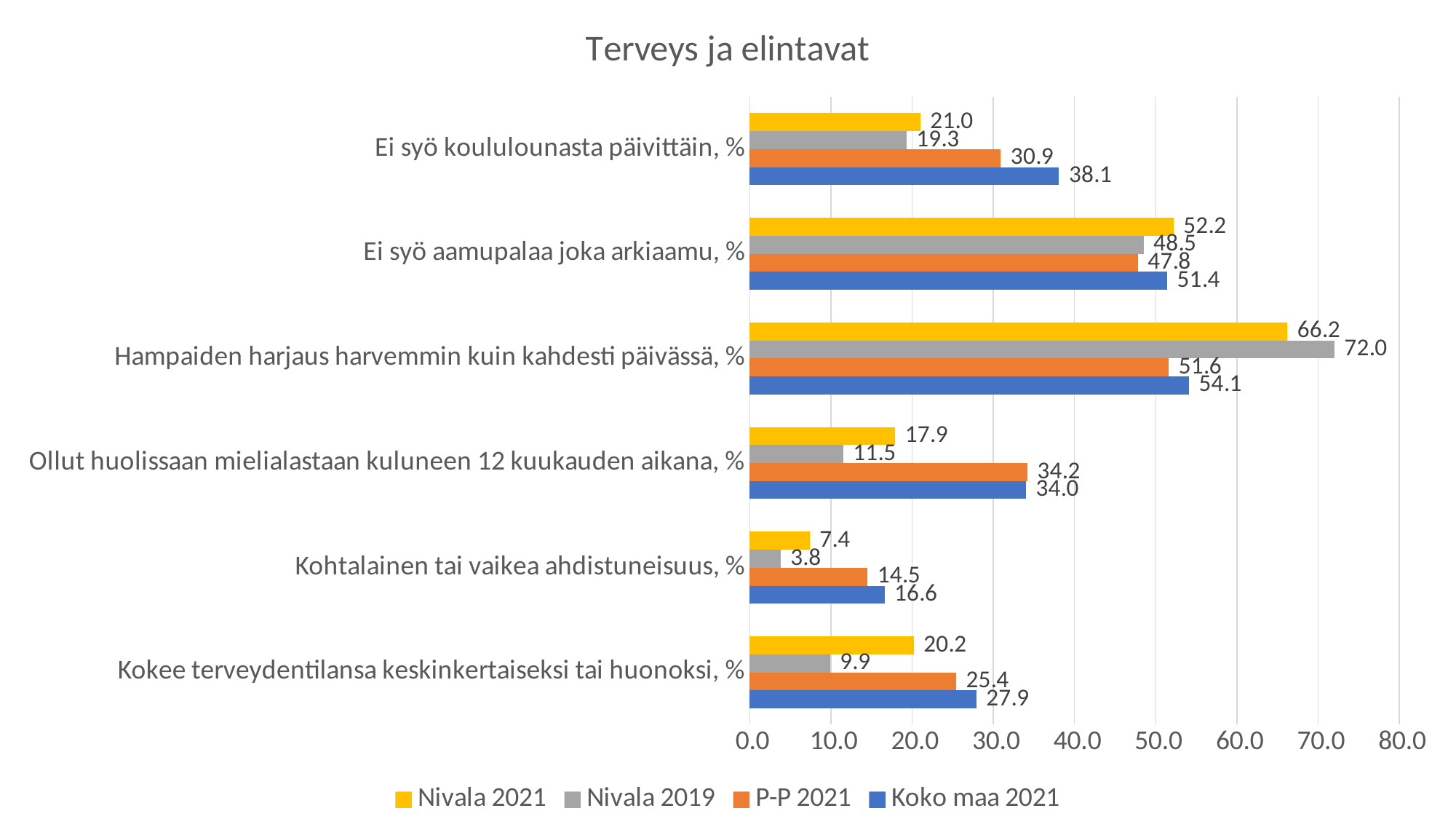
Which category has the highest value for the Nivala 2019 series? Hampaiden harjaus harvemmin kuin kahdesti päivässä, % How many categories are shown on the chart? 6 Is the Koko maa 2021 value for 'Ei syö aamupalaa joka arkiaamu, %' greater or less than 50.0? greater How many series does the legend list? 4 In the category 'Ollut huolissaan mielialastaan kuluneen 12 kuukauden aikana, %', which is larger: the P-P 2021 value or the Nivala 2021 value? P-P 2021 What is the value for Koko maa 2021 in the category 'Hampaiden harjaus harvemmin kuin kahdesti päivässä, %'? 54.1 What is the value for Nivala 2019 in the category 'Kohtalainen tai vaikea ahdistuneisuus, %'? 3.8 What is the difference between the Nivala 2021 and Nivala 2019 values in the category 'Kokee terveydentilansa keskinkertaiseksi tai huonoksi, %'? 10.3 Which category has the lowest value for the P-P 2021 series? Kohtalainen tai vaikea ahdistuneisuus, % What is the value for Nivala 2021 in the category 'Ei syö koululounasta päivittäin, %'? 21.0 What is the title of the chart? Terveys ja elintavat What kind of chart is shown on the slide? Bar chart